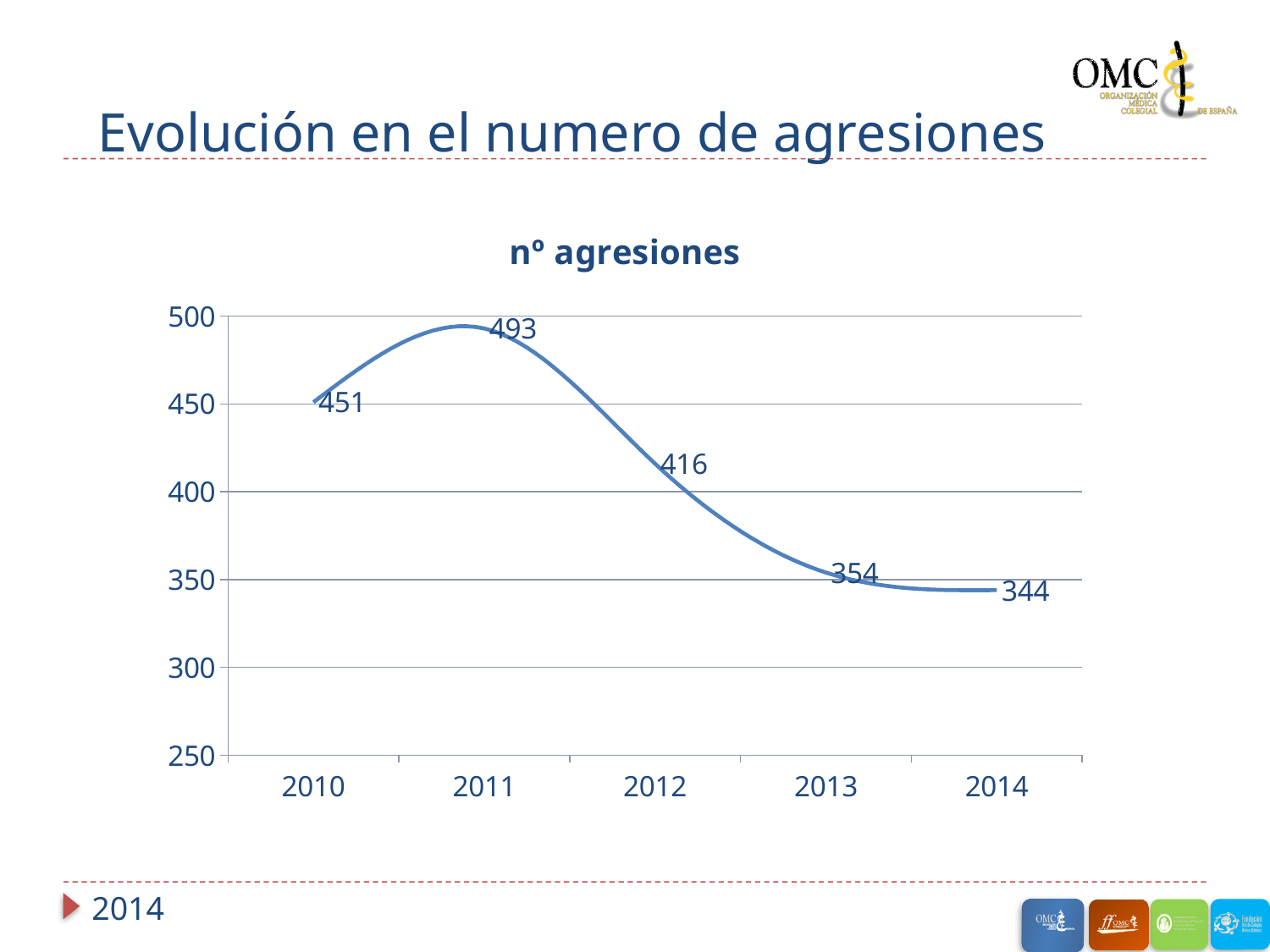
What kind of chart is shown? line chart What is the difference between the values for 2011 and 2014? 149 How many years are plotted on the chart? 5 What is the value for 2014? 344 What is the value for 2010? 451 Which year has the lowest number of agresiones? 2014 What is the value for 2011? 493 Is the value for 2013 greater or less than 400? less Which is larger, the value for 2010 or the value for 2012? 2010 What is the title of the chart? nº agresiones What is the value for 2012? 416 Which year has the highest number of agresiones? 2011